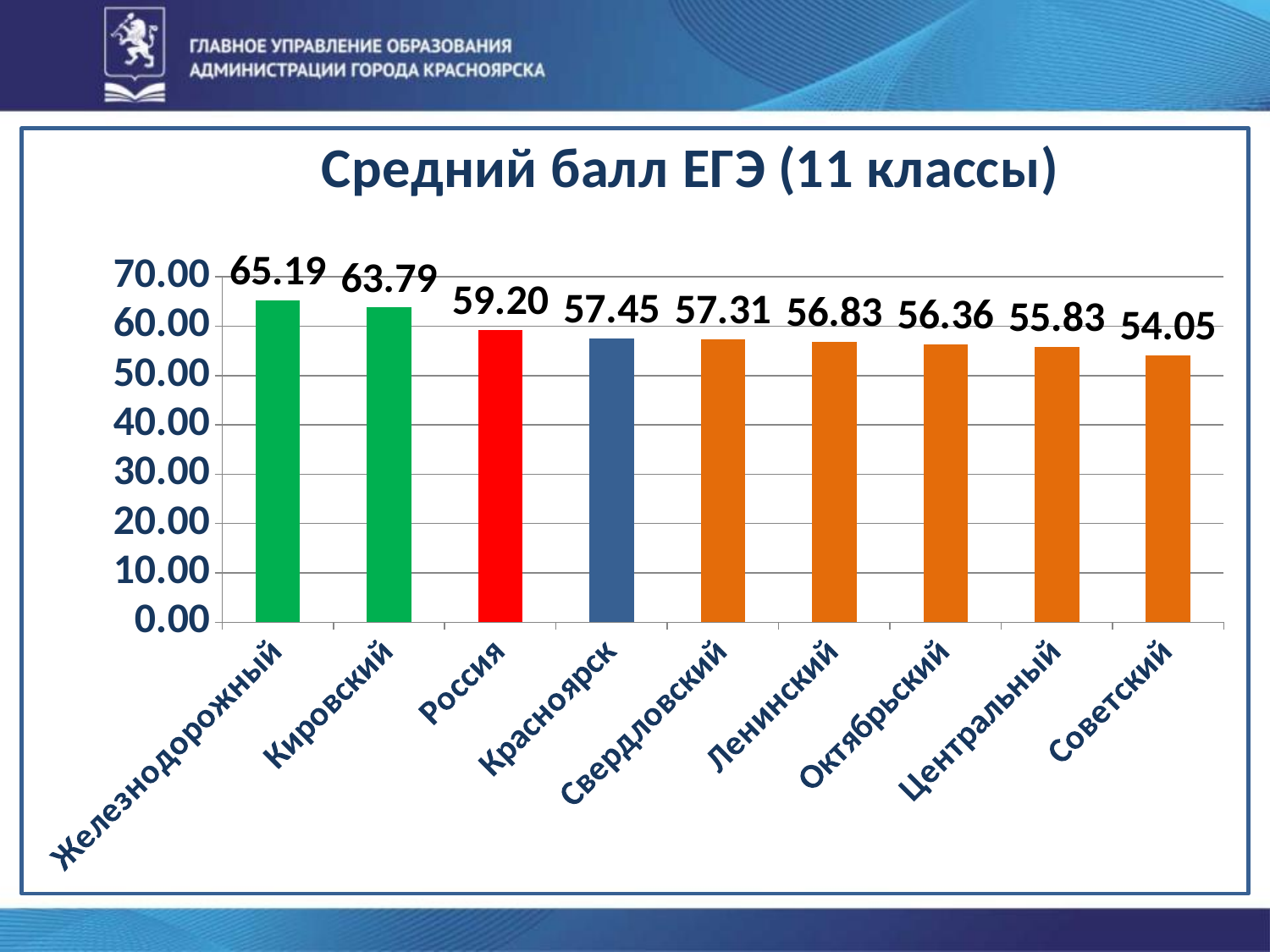
What is the value for Красноярск? 57.45 What is the value for Советский? 54.05 Which is larger, the value for Кировский or the value for Октябрьский? Кировский Which category has the highest value? Железнодорожный Is the value for Центральный greater or less than 60.00? less Which category has the lowest value? Советский What is the difference between the values for Железнодорожный and Кировский? 1.40 How many categories are shown on the x axis? 9 What is the value for Железнодорожный? 65.19 What is the difference between the values for Россия and Красноярск? 1.75 What kind of chart is shown on the slide? bar chart What is the value for Россия? 59.20